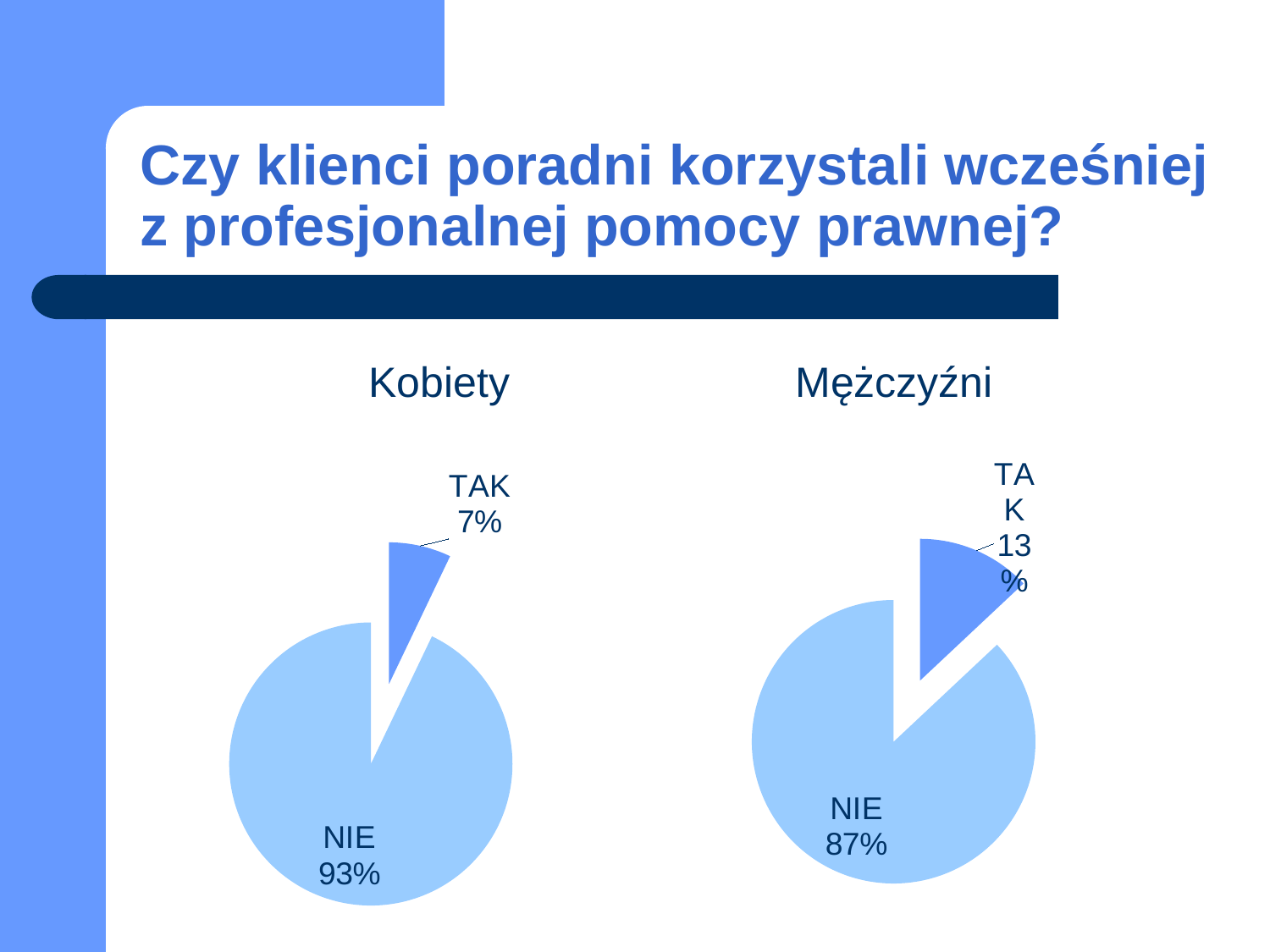
In the Kobiety chart, what percentage is shown for NIE? 93% In the Mężczyźni chart, what percentage is shown for TAK? 13% What is the title of the chart on the right? Mężczyźni How many slices does the Mężczyźni chart have? 2 In the Kobiety chart, what percentage is shown for TAK? 7% What type of chart is the Kobiety chart? Pie chart In the Mężczyźni chart, what percentage is shown for NIE? 87% In the Mężczyźni chart, which slice is the smallest? TAK Which is larger: the TAK share in the Kobiety chart or the TAK share in the Mężczyźni chart? Mężczyźni In the Kobiety chart, what is the difference between the NIE and TAK percentages? 86% In the Kobiety chart, which slice is the largest? NIE How many pie charts are on the slide? 2